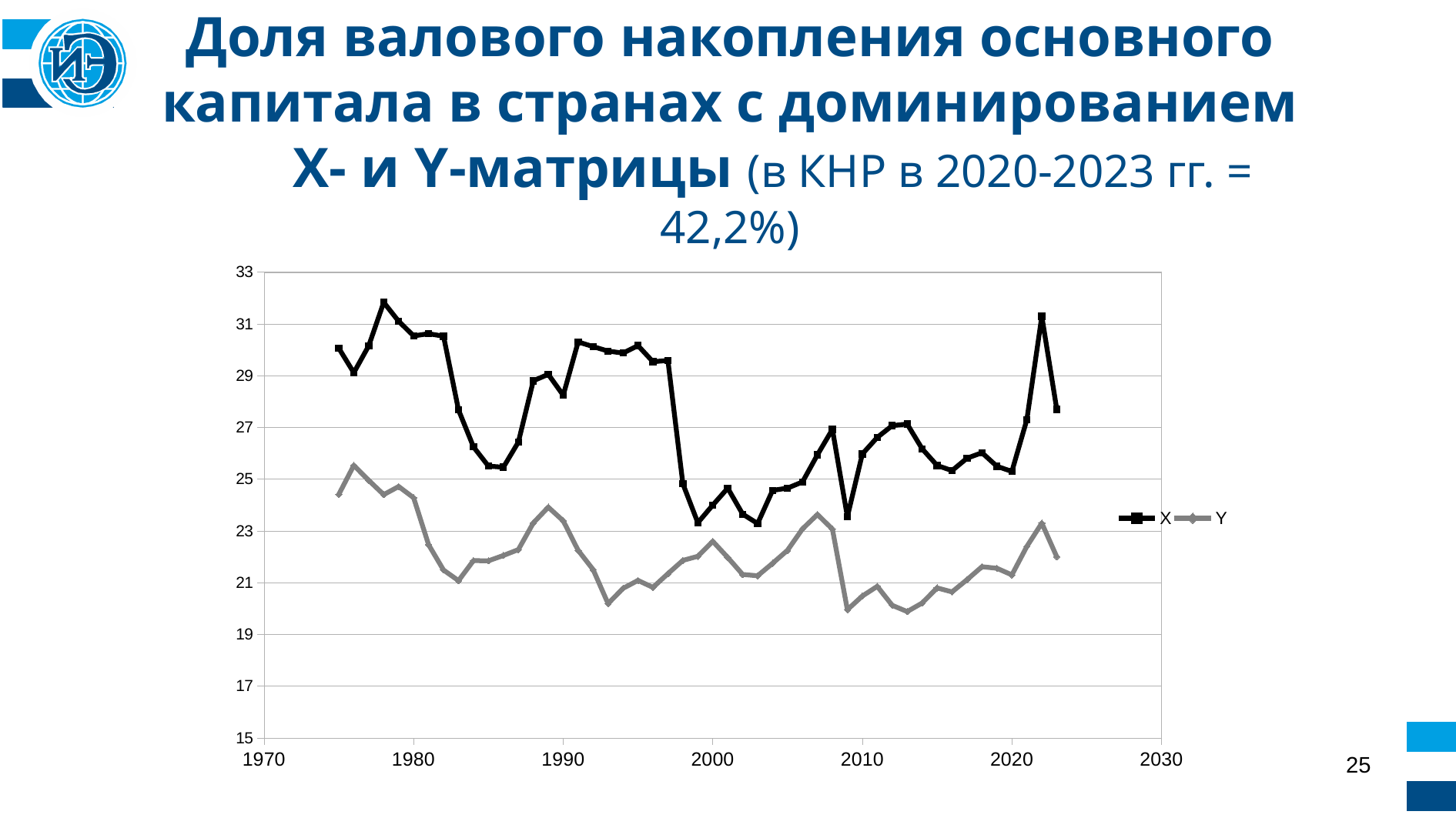
Is the value of series X in 1978 greater or less than 31? greater In 1978, which series has the larger value, X or Y? X What kind of chart is shown on the slide? line chart Which series is drawn with the black line, X or Y? X Is the value of series Y in 1976 greater or less than 25? greater What are the names of the two series in the legend? X and Y Is the value of series Y in 1993 greater or less than 21? less Which series stays above the other across the whole period shown, X or Y? X Does series X rise or fall between 1997 and 1999? fall How many series does the legend list? 2 Does series Y rise or fall between 1976 and 1983? fall